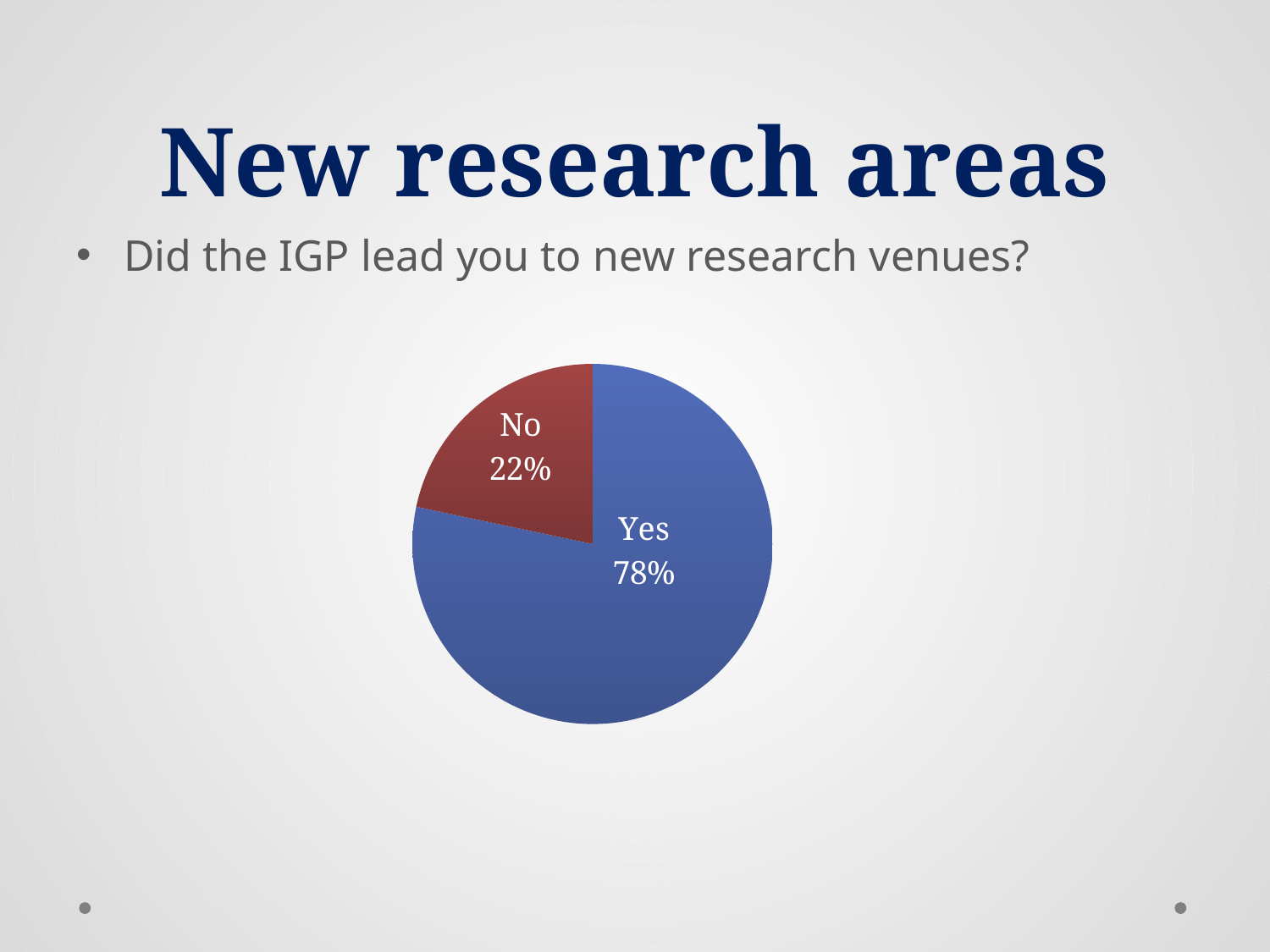
Which is larger, the Yes slice or the No slice? Yes What share of the pie does the Yes slice represent? 78% What colour is the Yes slice of the pie? blue Which slice of the pie is the smallest? No What share of the pie does the No slice represent? 22% How many slices does the pie chart have? 2 What colour is the No slice of the pie? red What kind of chart is shown on the slide? pie chart What is the difference in percentage points between the Yes and No slices? 56 Which slice of the pie is the largest? Yes